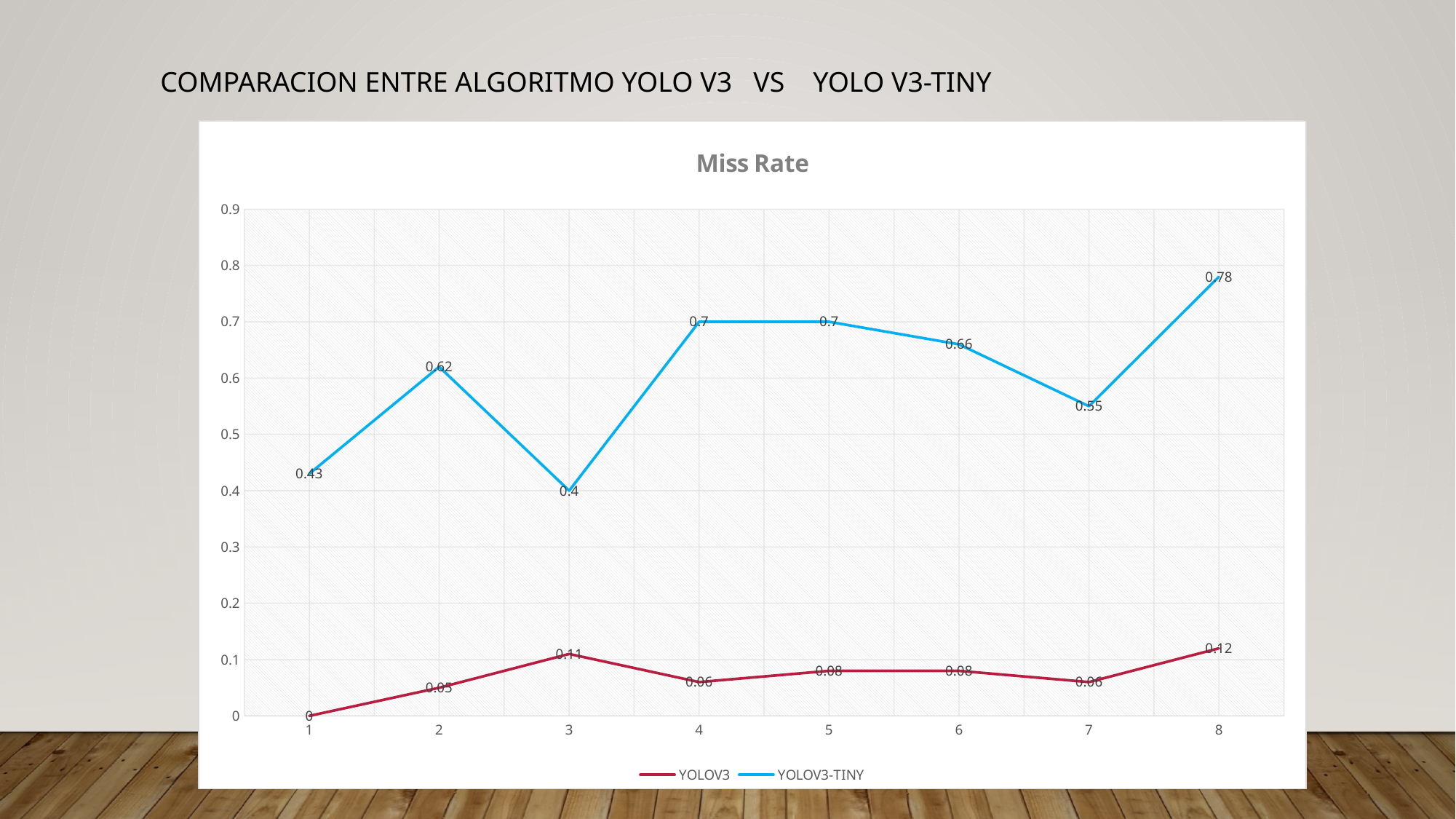
Is the YOLOV3-TINY Miss Rate at point 7 greater or less than 0.5? greater What kind of chart is shown on the slide? Line chart At which point does YOLOV3-TINY have its highest Miss Rate? 8 What is the Miss Rate value for YOLOV3 at point 3? 0.11 At which point does YOLOV3-TINY have its lowest Miss Rate? 3 What is the Miss Rate value for YOLOV3-TINY at point 8? 0.78 How many series does the legend list? 2 What is the Miss Rate value for YOLOV3-TINY at point 1? 0.43 At which point does YOLOV3 have its lowest Miss Rate? 1 How many points are plotted along the x axis? 8 What is the difference between the YOLOV3-TINY and YOLOV3 Miss Rate values at point 4? 0.64 Which series has the higher Miss Rate at point 2, YOLOV3 or YOLOV3-TINY? YOLOV3-TINY